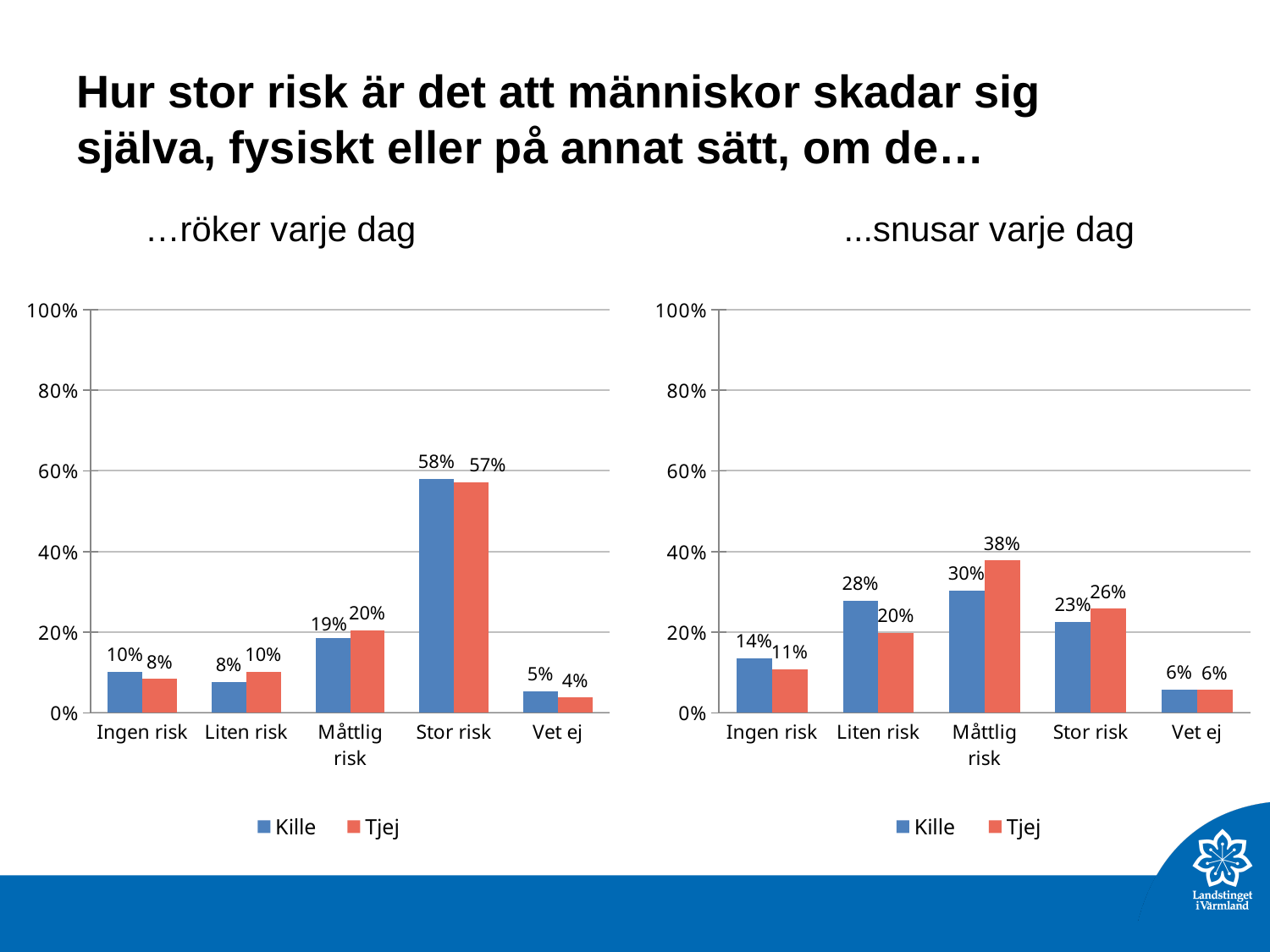
In the '…röker varje dag' chart, what is the value for Kille at Stor risk? 58% How many series does the legend of the '…röker varje dag' chart list? 2 What kind of chart is the '...snusar varje dag' chart? Bar chart In the '...snusar varje dag' chart, which is larger at Liten risk, Kille or Tjej? Kille In the '…röker varje dag' chart, which colour represents Tjej? Red/orange How many categories are shown on the x axis of the '...snusar varje dag' chart? 5 In the '…röker varje dag' chart, which category has the highest value for Tjej? Stor risk In the '...snusar varje dag' chart, what is the value for Tjej at Måttlig risk? 38% In the '...snusar varje dag' chart, which category has the lowest value for Kille? Vet ej In the '...snusar varje dag' chart, what is the difference between Tjej and Kille at Måttlig risk? 8% In the '…röker varje dag' chart, what is the difference between Kille and Tjej at Vet ej? 1% In the '…röker varje dag' chart, is the value for Kille at Stor risk greater or less than 40%? greater